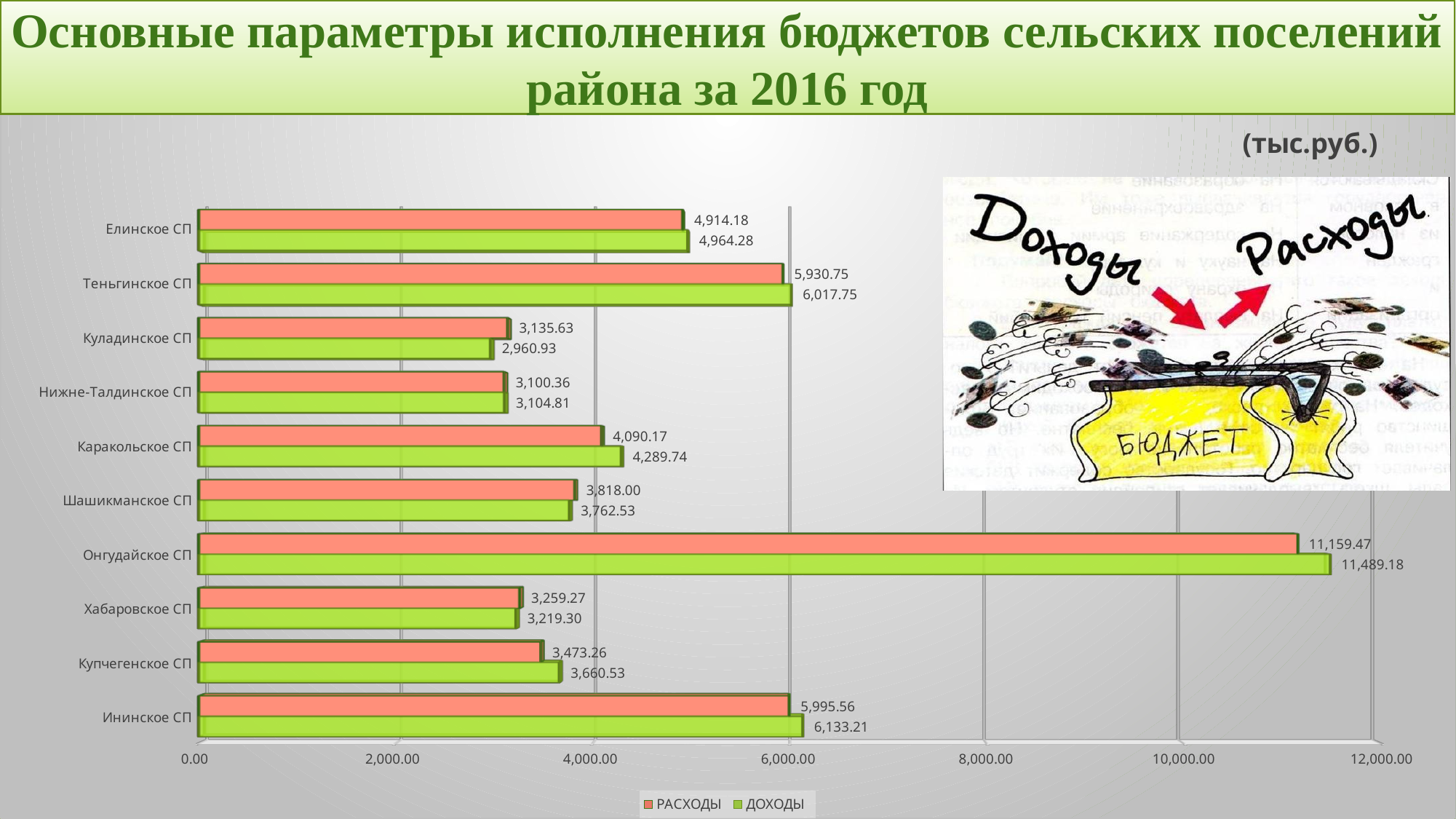
What kind of chart is shown on the slide? Bar chart How many settlements (categories) are shown on the chart? 10 What is the РАСХОДЫ value for Теньгинское СП? 5,930.75 Which settlement has the highest ДОХОДЫ value? Онгудайское СП How many series does the legend list? 2 What is the ДОХОДЫ value for Купчегенское СП? 3,660.53 What is the difference between ДОХОДЫ and РАСХОДЫ for Онгудайское СП? 329.71 Which settlement has the lowest ДОХОДЫ value? Куладинское СП What is the ДОХОДЫ value for Онгудайское СП? 11,489.18 What is the difference between ДОХОДЫ and РАСХОДЫ for Ининское СП? 137.65 What unit is indicated for the chart values? тыс.руб. For Куладинское СП, which is larger: РАСХОДЫ or ДОХОДЫ? РАСХОДЫ